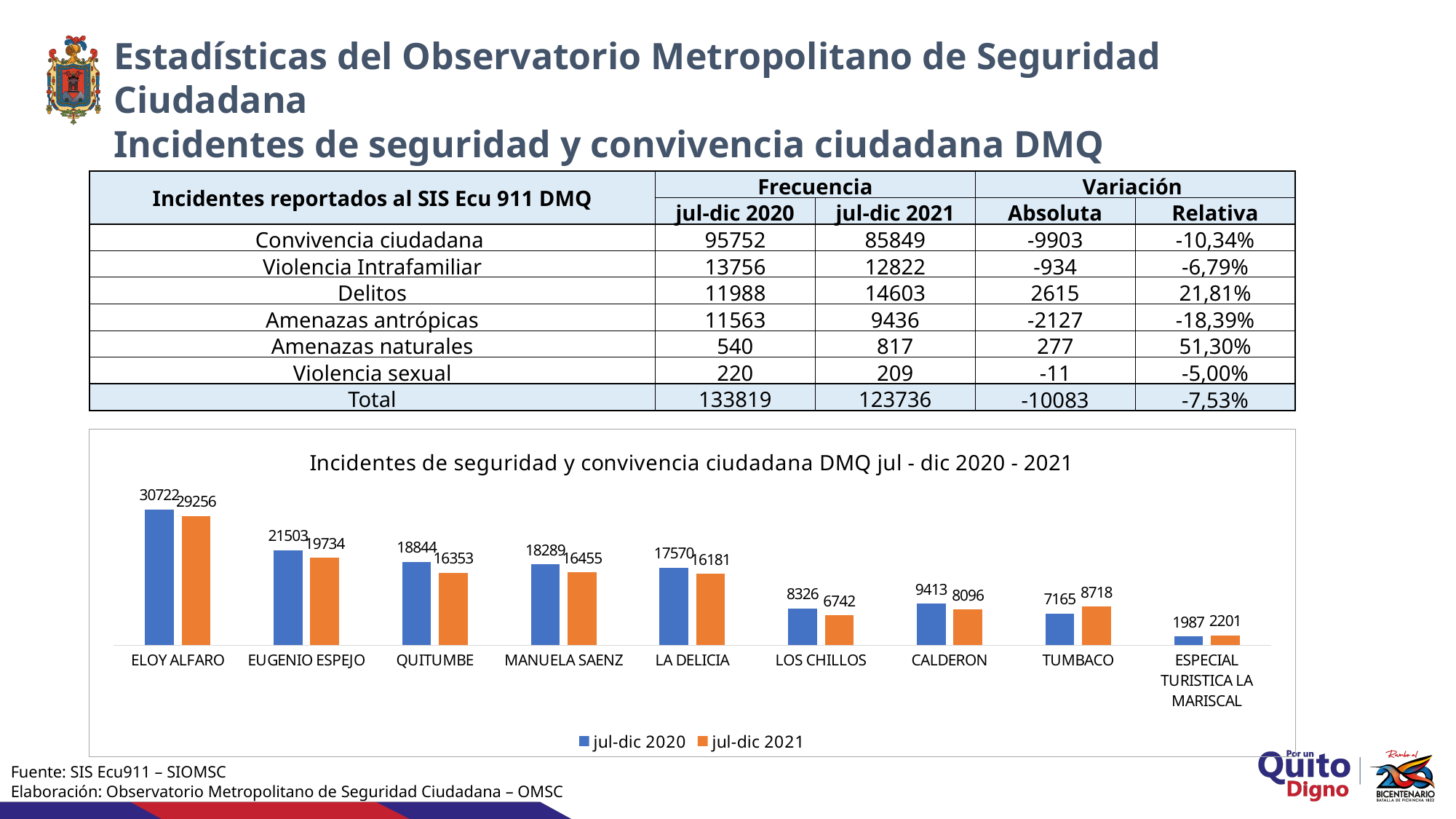
Which category has the lowest jul-dic 2021 value? ESPECIAL TURISTICA LA MARISCAL How many categories are shown on the x axis of the chart? 9 Which category has the highest jul-dic 2020 value? ELOY ALFARO Which colour represents the jul-dic 2021 series in the chart? orange What is the difference between the jul-dic 2020 and jul-dic 2021 values for QUITUMBE? 2491 What is the title of the chart? Incidentes de seguridad y convivencia ciudadana DMQ jul - dic 2020 - 2021 Which is larger for CALDERON: the jul-dic 2020 value or the jul-dic 2021 value? jul-dic 2020 How many series does the chart legend list? 2 What is the jul-dic 2021 value for TUMBACO? 8718 What is the jul-dic 2020 value for ELOY ALFARO? 30722 What type of chart is shown on the slide? bar chart What is the jul-dic 2021 value for LOS CHILLOS? 6742